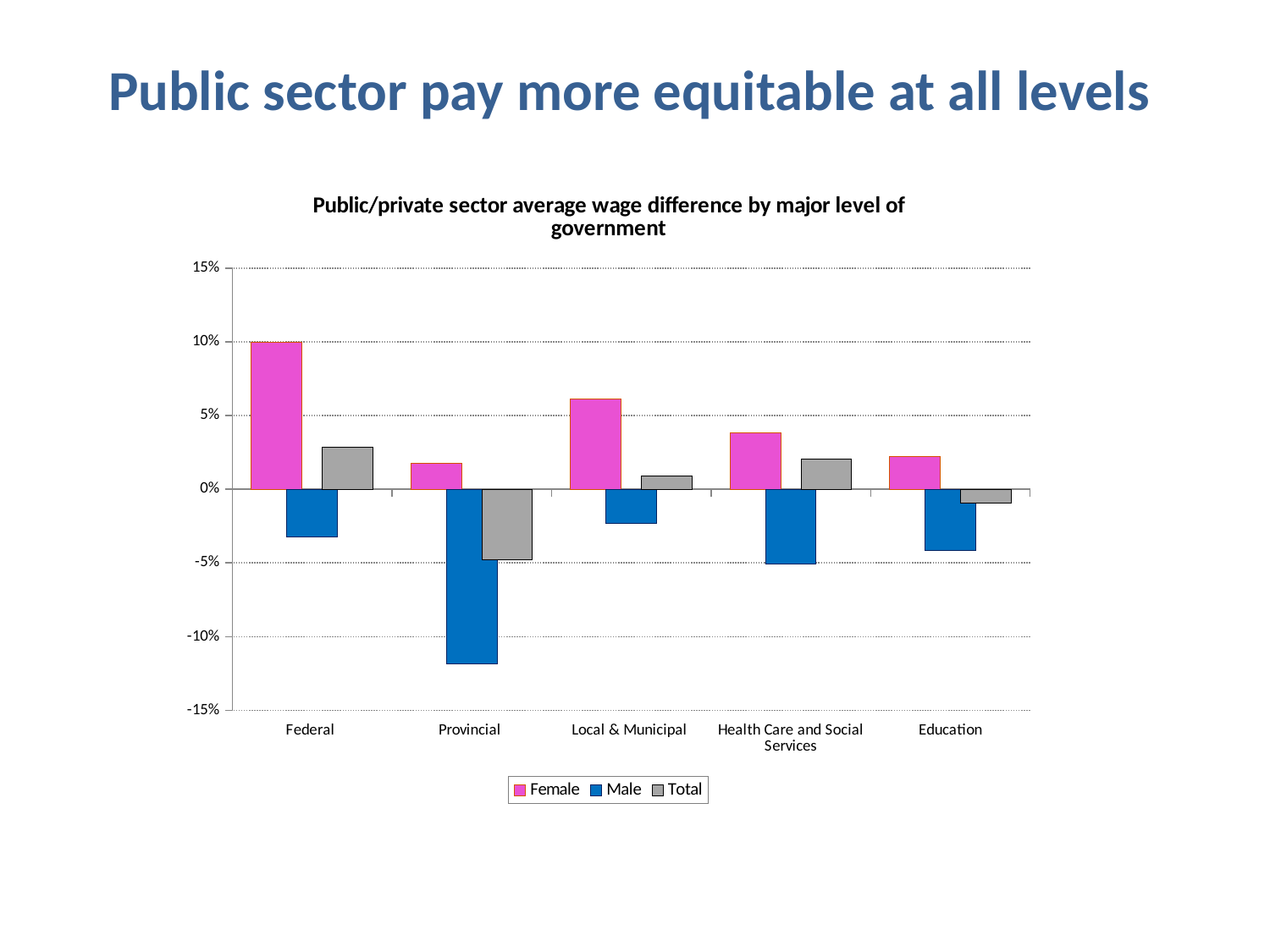
What is the title of the chart? Public/private sector average wage difference by major level of government Is the Female value for Local & Municipal greater or less than 5%? greater What kind of chart is shown on the slide? bar chart Which colour represents the Male series in the legend? blue Is the Male value for Provincial greater or less than -10%? less How many categories are shown along the x axis? 5 Is the Female value for Federal greater or less than 5%? greater How many series does the legend list? 3 Which is larger, the Total value for Federal or the Total value for Provincial? Federal Which category has the lowest Male value? Provincial Which is larger, the Female value for Federal or the Female value for Provincial? Federal Which category has the highest Female value? Federal